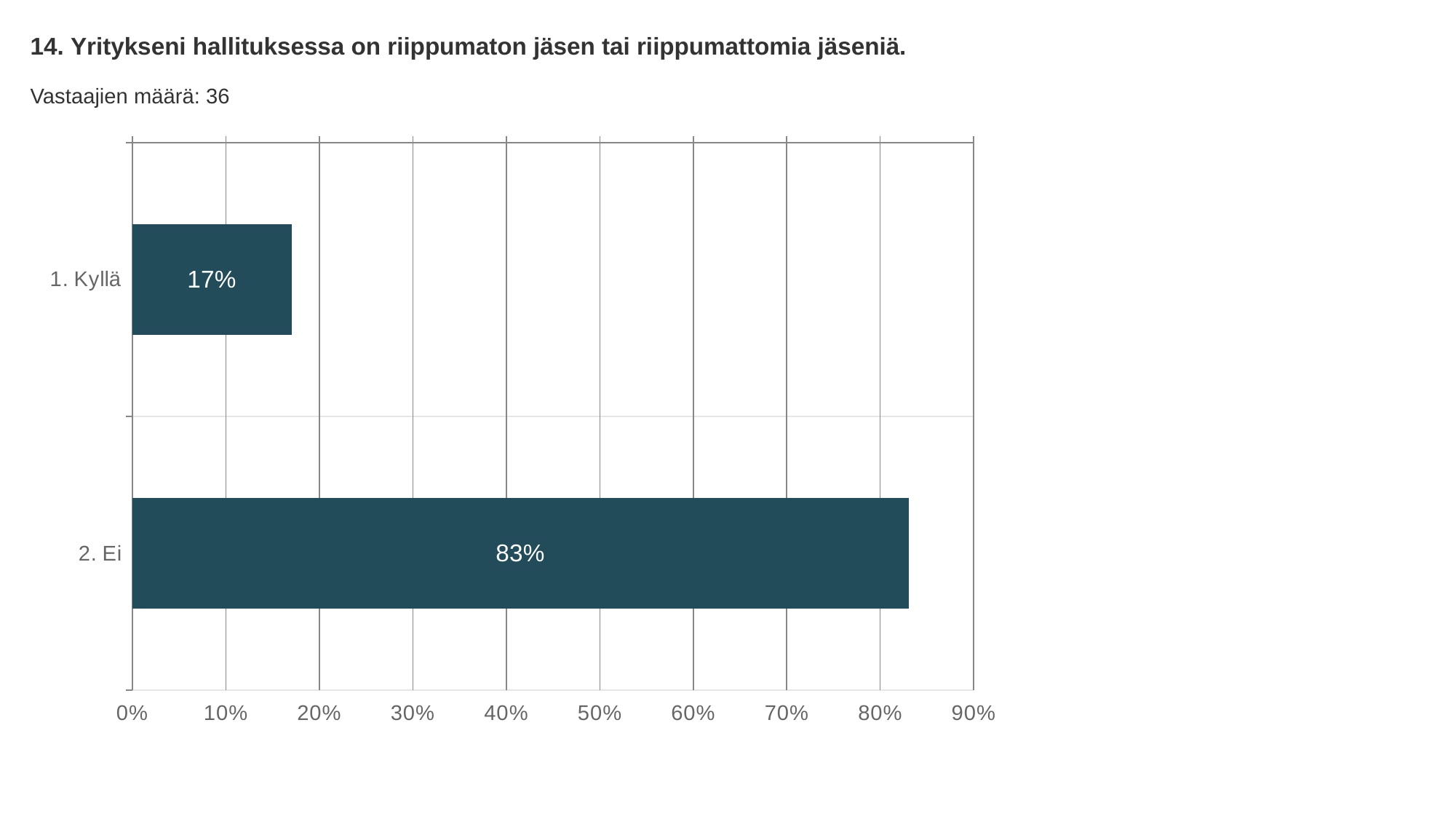
Which is larger, the value for "1. Kyllä" or the value for "2. Ei"? 2. Ei What kind of chart is shown on the slide? bar chart Which category has the highest value? 2. Ei How many categories are shown in the chart? 2 Which category has the lowest value? 1. Kyllä What is the value for "2. Ei"? 83% Is the value for "1. Kyllä" greater or less than 20%? less Is the value for "2. Ei" greater or less than 50%? greater What is the value for "1. Kyllä"? 17% What is the number of respondents (Vastaajien määrä) shown on the slide? 36 What is the highest value shown on the x axis? 90% What is the difference between the values for "2. Ei" and "1. Kyllä"? 66%